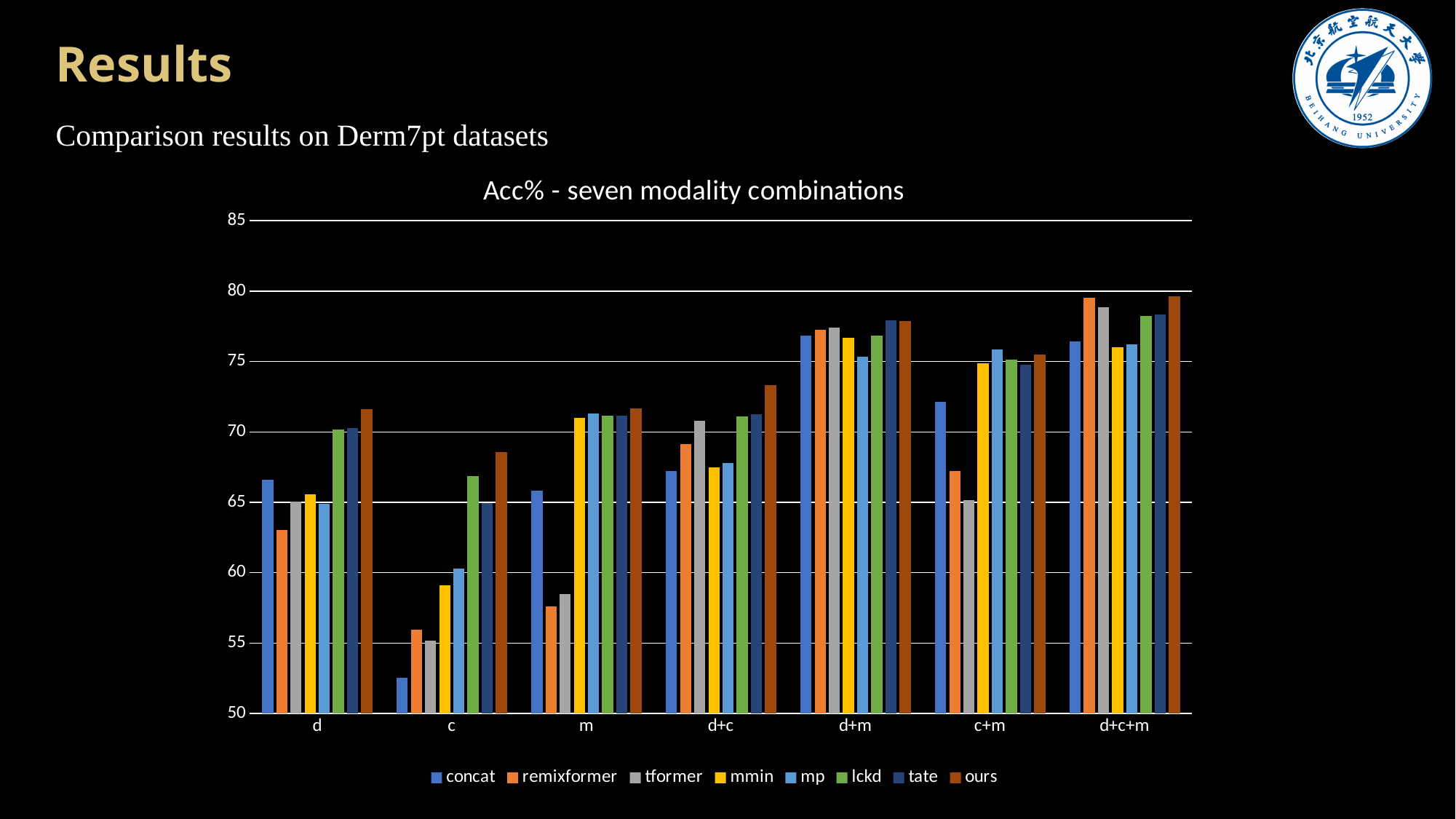
Is the value for ours in the d+c+m category greater or less than 75? greater What kind of chart is shown on the slide? bar chart In the c category, which is larger, ours or lckd? ours In which category does ours have its highest value? d+c+m In which category does concat have its lowest value? c How many series does the legend list? 8 Is the value for concat in the c+m category greater or less than 70? greater How many modality combinations (categories) are shown on the x axis? 7 Is the value for concat in the c category greater or less than 55? less What is the title of the chart? Acc% - seven modality combinations